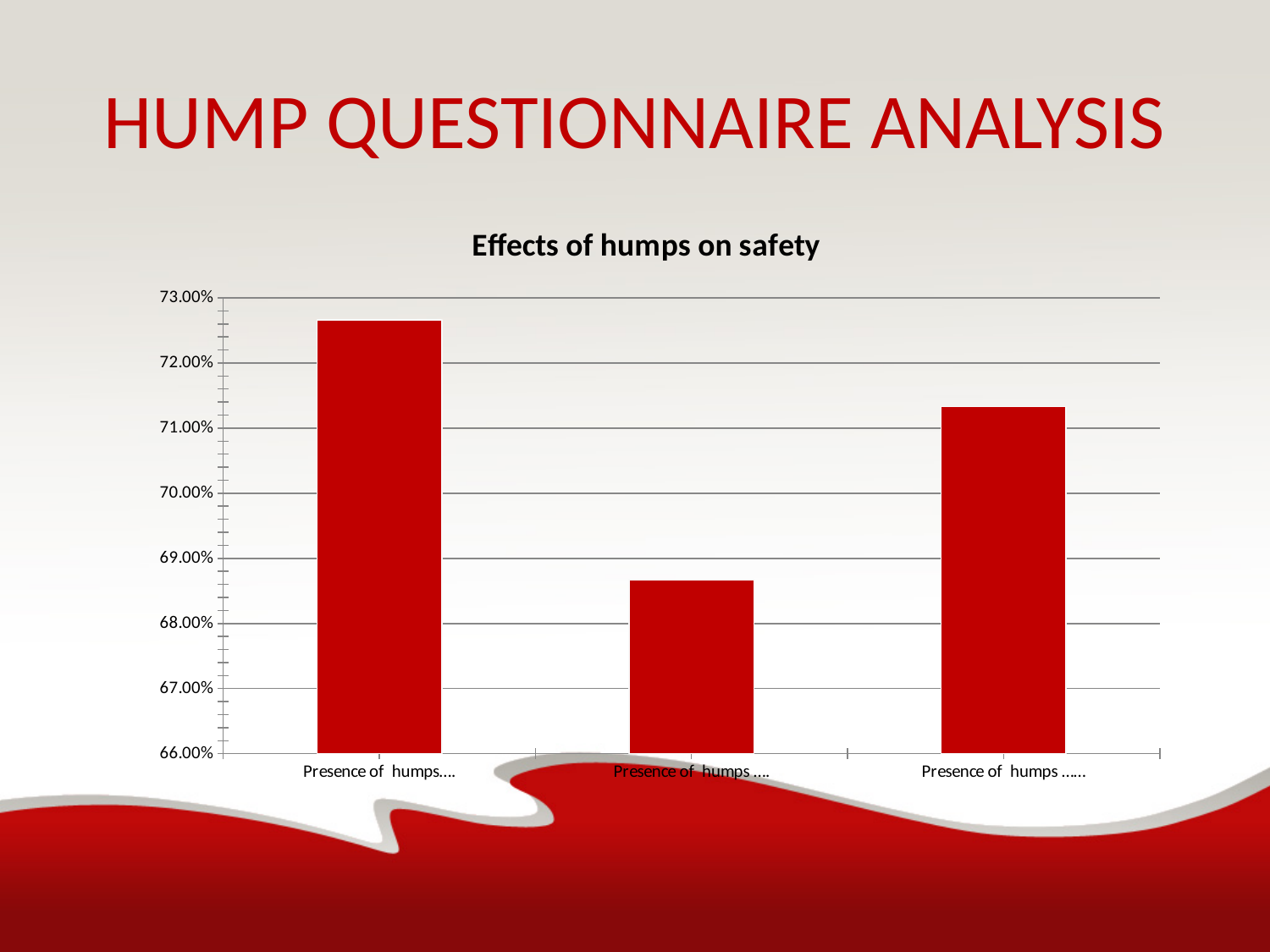
Does the value fall or rise from the left bar to the middle bar? fall Is the value of the right bar greater or less than 71.00%? greater Which bar is the lowest: the left, middle or right one? middle Which bar is the highest: the left, middle or right one? left Is the value of the middle bar greater or less than 68.00%? greater Is the value of the left bar greater or less than 72.00%? greater What kind of chart is shown on the slide? bar chart Which is larger, the value of the left bar or the value of the right bar? left bar What colour are the bars in the chart? red How many bars are plotted in the chart? 3 What is the title of the chart? Effects of humps on safety